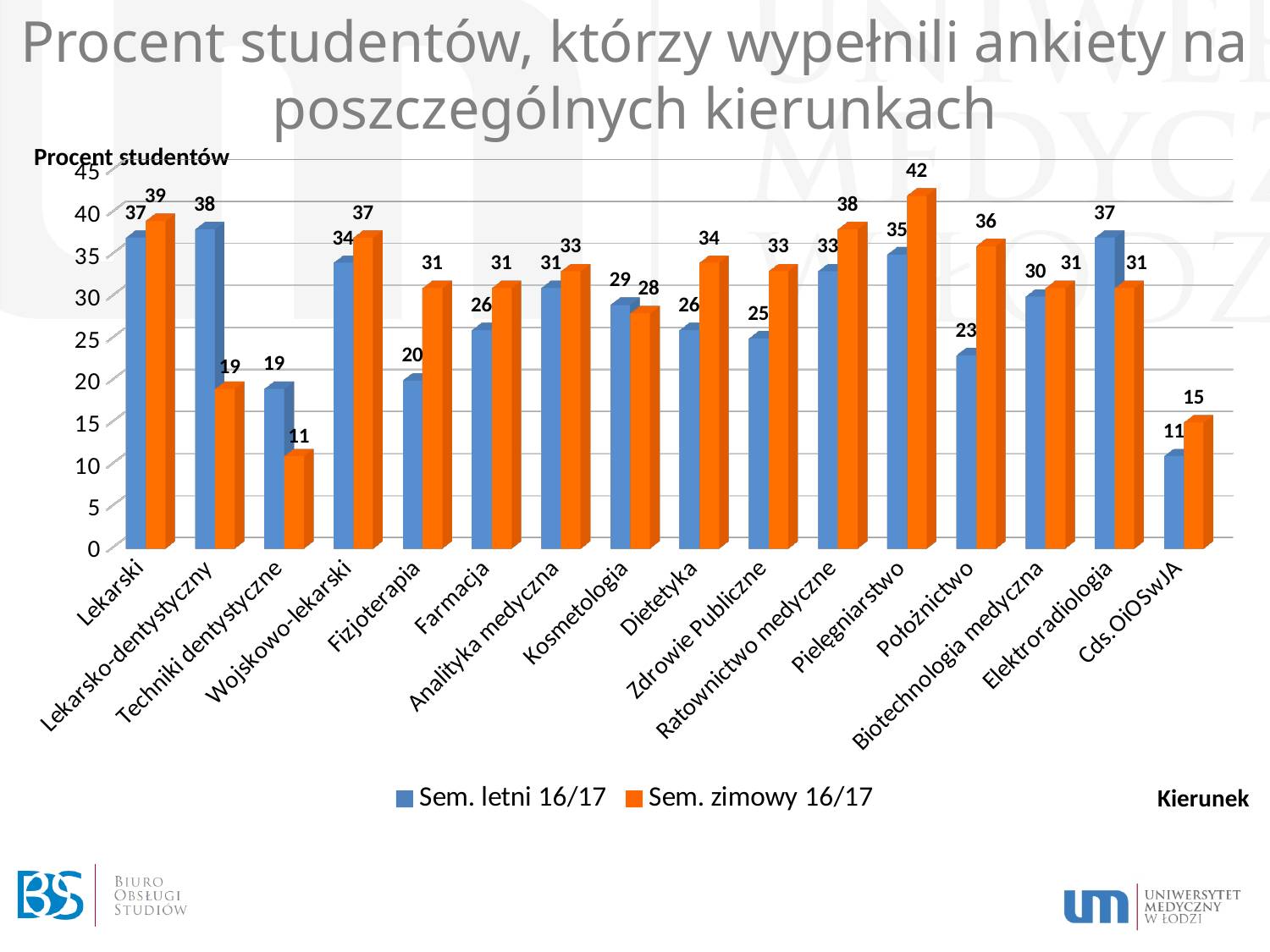
Which category has the highest value in the Sem. letni 16/17 series? Lekarsko-dentystyczny What kind of chart is shown on the slide? bar chart What is the value for Położnictwo in the Sem. zimowy 16/17 series? 36 What is the value for Fizjoterapia in the Sem. letni 16/17 series? 20 How many series does the legend list? 2 What is the label of the vertical axis? Procent studentów What is the value for Pielęgniarstwo in the Sem. zimowy 16/17 series? 42 Which category has the highest value in the Sem. zimowy 16/17 series? Pielęgniarstwo What is the difference between the Sem. letni 16/17 and Sem. zimowy 16/17 values for Lekarsko-dentystyczny? 19 For Elektroradiologia, which series has the larger value: Sem. letni 16/17 or Sem. zimowy 16/17? Sem. letni 16/17 How many categories (kierunki) are shown on the x axis? 16 Which category has the lowest value in the Sem. letni 16/17 series? Cds.OiOSwJA